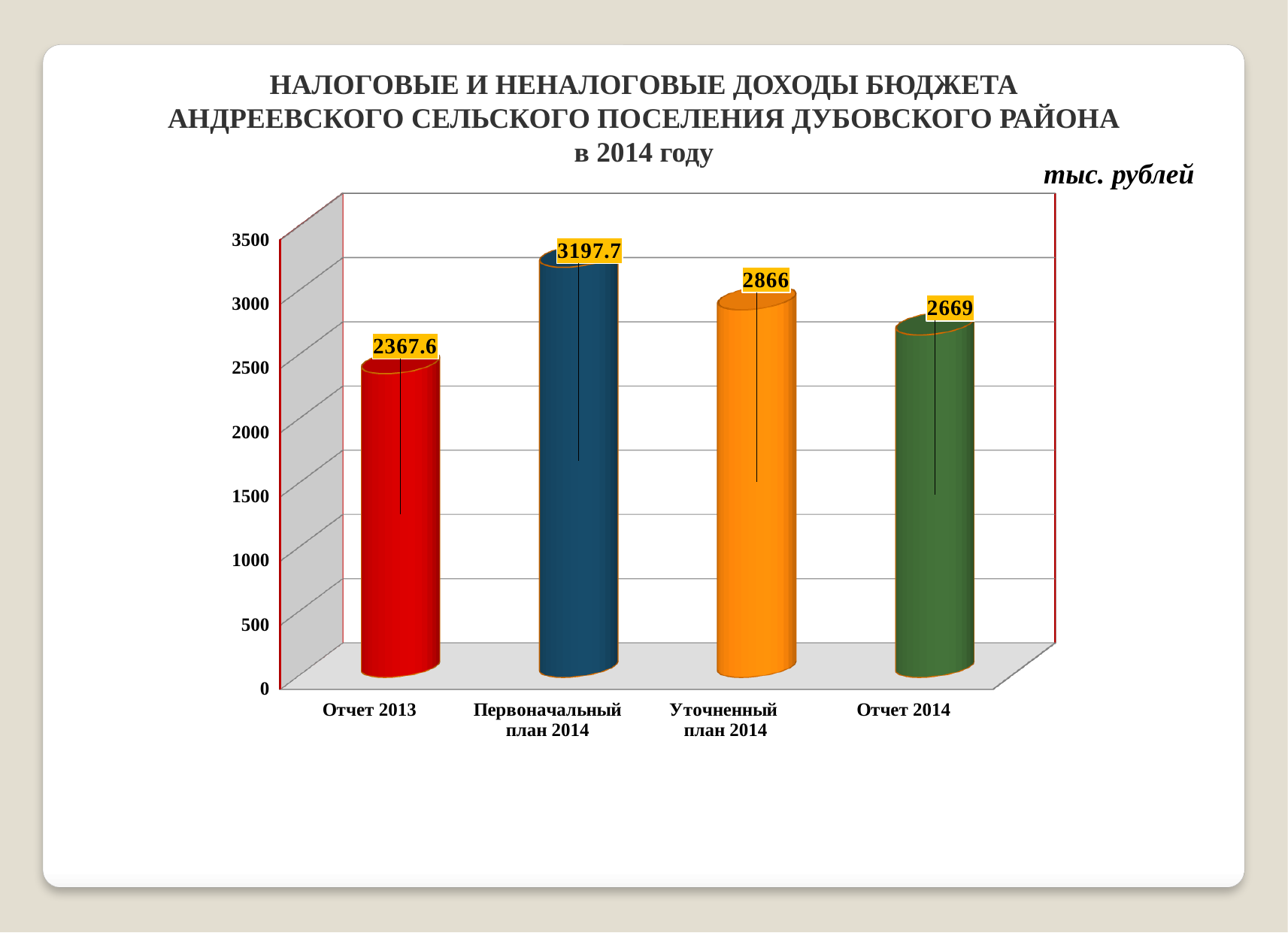
What is the difference between Первоначальный план 2014 and Уточненный план 2014? 331.7 What is the value for Первоначальный план 2014? 3197.7 How many categories are shown on the chart? 4 What kind of chart is shown on the slide? Bar chart What is the value for Уточненный план 2014? 2866 Which is larger, Уточненный план 2014 or Отчет 2014? Уточненный план 2014 Which category has the lowest value? Отчет 2013 What is the difference between Отчет 2014 and Отчет 2013? 301.4 What is the value for Отчет 2014? 2669 Which category has the highest value? Первоначальный план 2014 What unit of measurement is indicated for the chart values? тыс. рублей What is the value for Отчет 2013? 2367.6